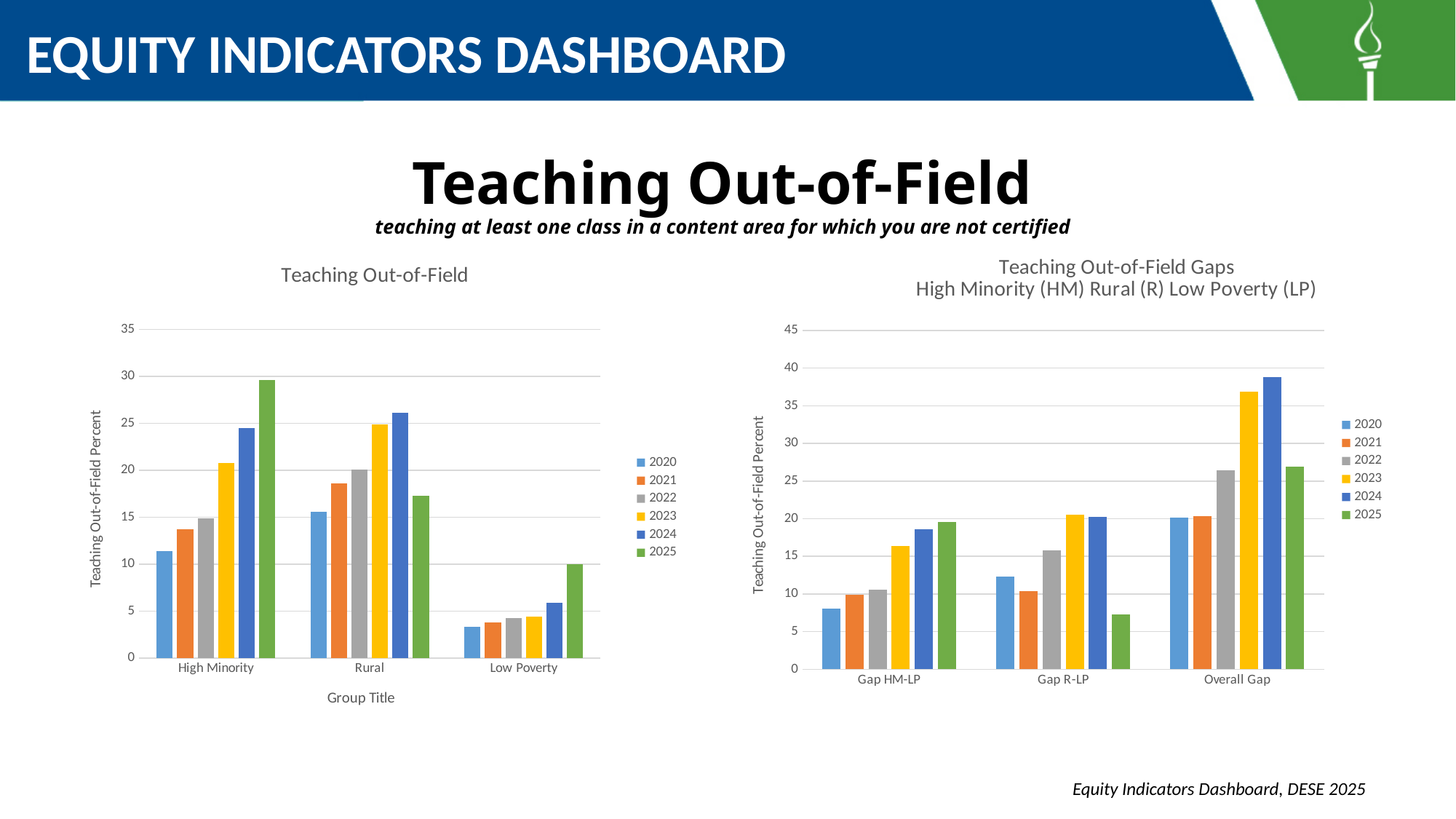
In the chart titled "Teaching Out-of-Field Gaps" on the right, how many gap categories are shown on the x axis? 3 In the chart titled "Teaching Out-of-Field" on the left, what kind of chart is it? bar chart In the chart titled "Teaching Out-of-Field" on the left, is the 2025 value for High Minority greater or less than 25? greater In the chart titled "Teaching Out-of-Field Gaps" on the right, which year has the highest Overall Gap? 2024 In the chart titled "Teaching Out-of-Field" on the left, what is the label on the vertical axis? Teaching Out-of-Field Percent In the chart titled "Teaching Out-of-Field Gaps" on the right, is the 2025 value for Gap R-LP greater or less than 10? less In the chart titled "Teaching Out-of-Field" on the left, which year has the lowest value for Low Poverty? 2020 In the chart titled "Teaching Out-of-Field" on the left, how many groups are shown on the x axis? 3 In the chart titled "Teaching Out-of-Field" on the left, do the High Minority values rise or fall from 2020 to 2025? rise In the chart titled "Teaching Out-of-Field" on the left, how many series does the legend list? 6 In the chart titled "Teaching Out-of-Field" on the left, which year has the highest value for High Minority? 2025 In the chart titled "Teaching Out-of-Field" on the left, which is larger for Rural: the 2024 value or the 2025 value? 2024